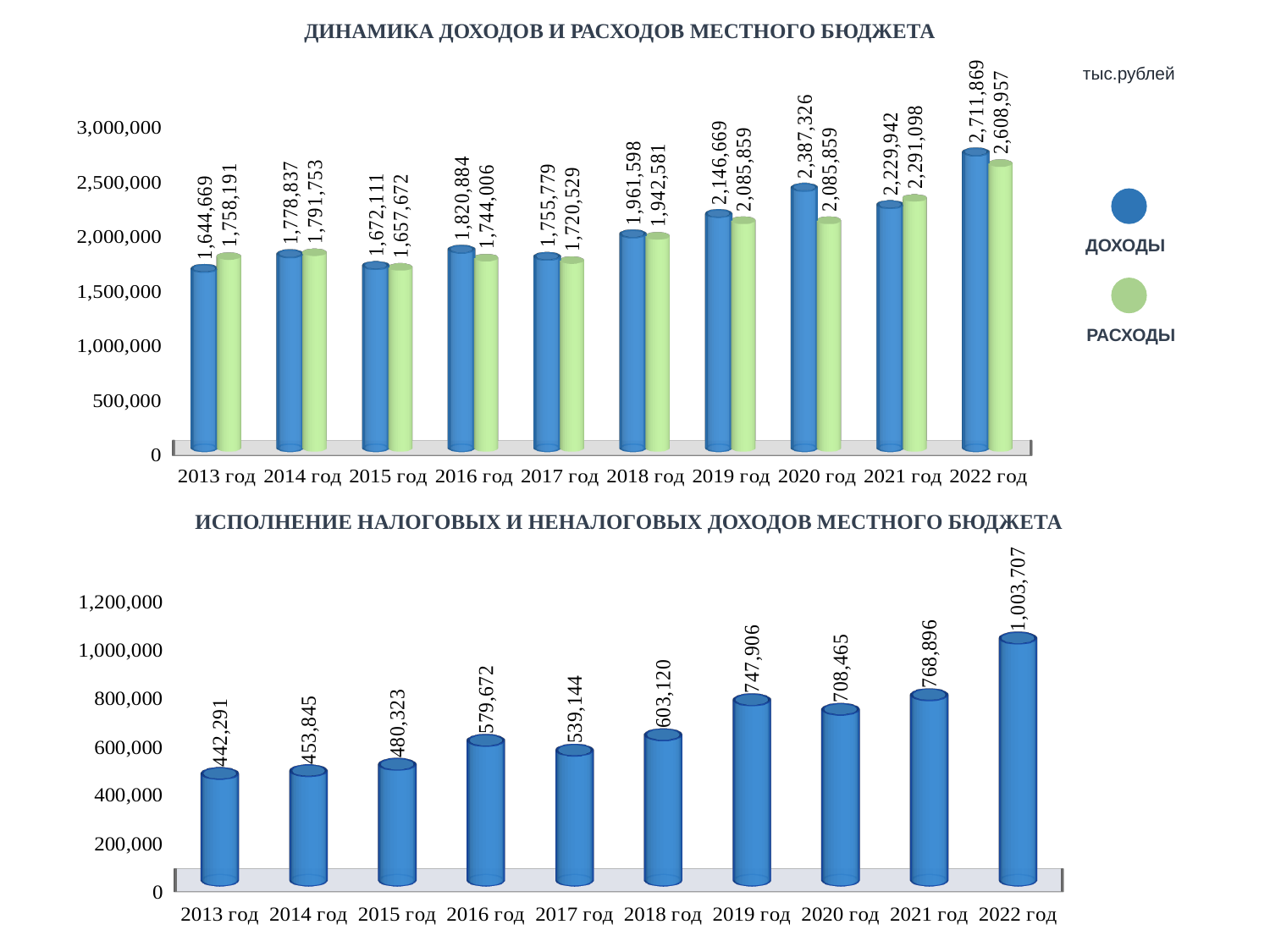
In the top chart (ДИНАМИКА ДОХОДОВ И РАСХОДОВ МЕСТНОГО БЮДЖЕТА), what is the difference between ДОХОДЫ and РАСХОДЫ in 2022 год? 102,912 In the top chart (ДИНАМИКА ДОХОДОВ И РАСХОДОВ МЕСТНОГО БЮДЖЕТА), what is the value of ДОХОДЫ for 2020 год? 2,387,326 In the top chart (ДИНАМИКА ДОХОДОВ И РАСХОДОВ МЕСТНОГО БЮДЖЕТА), which year has the highest ДОХОДЫ value? 2022 год In the bottom chart (ИСПОЛНЕНИЕ НАЛОГОВЫХ И НЕНАЛОГОВЫХ ДОХОДОВ МЕСТНОГО БЮДЖЕТА), what is the value for 2019 год? 747,906 In the top chart (ДИНАМИКА ДОХОДОВ И РАСХОДОВ МЕСТНОГО БЮДЖЕТА), which year has the lowest ДОХОДЫ value? 2013 год How many series does the legend of the top chart (ДИНАМИКА ДОХОДОВ И РАСХОДОВ МЕСТНОГО БЮДЖЕТА) list? 2 In the top chart (ДИНАМИКА ДОХОДОВ И РАСХОДОВ МЕСТНОГО БЮДЖЕТА), what is the value of РАСХОДЫ for 2016 год? 1,744,006 What unit is indicated for the values in the top chart (ДИНАМИКА ДОХОДОВ И РАСХОДОВ МЕСТНОГО БЮДЖЕТА)? тыс.рублей In the bottom chart (ИСПОЛНЕНИЕ НАЛОГОВЫХ И НЕНАЛОГОВЫХ ДОХОДОВ МЕСТНОГО БЮДЖЕТА), what is the difference between the values for 2022 год and 2021 год? 234,811 In the top chart (ДИНАМИКА ДОХОДОВ И РАСХОДОВ МЕСТНОГО БЮДЖЕТА), which is larger in 2021 год: ДОХОДЫ or РАСХОДЫ? РАСХОДЫ How many years are shown on the x axis of the bottom chart (ИСПОЛНЕНИЕ НАЛОГОВЫХ И НЕНАЛОГОВЫХ ДОХОДОВ МЕСТНОГО БЮДЖЕТА)? 10 What kind of chart is the bottom chart (ИСПОЛНЕНИЕ НАЛОГОВЫХ И НЕНАЛОГОВЫХ ДОХОДОВ МЕСТНОГО БЮДЖЕТА)? Bar chart